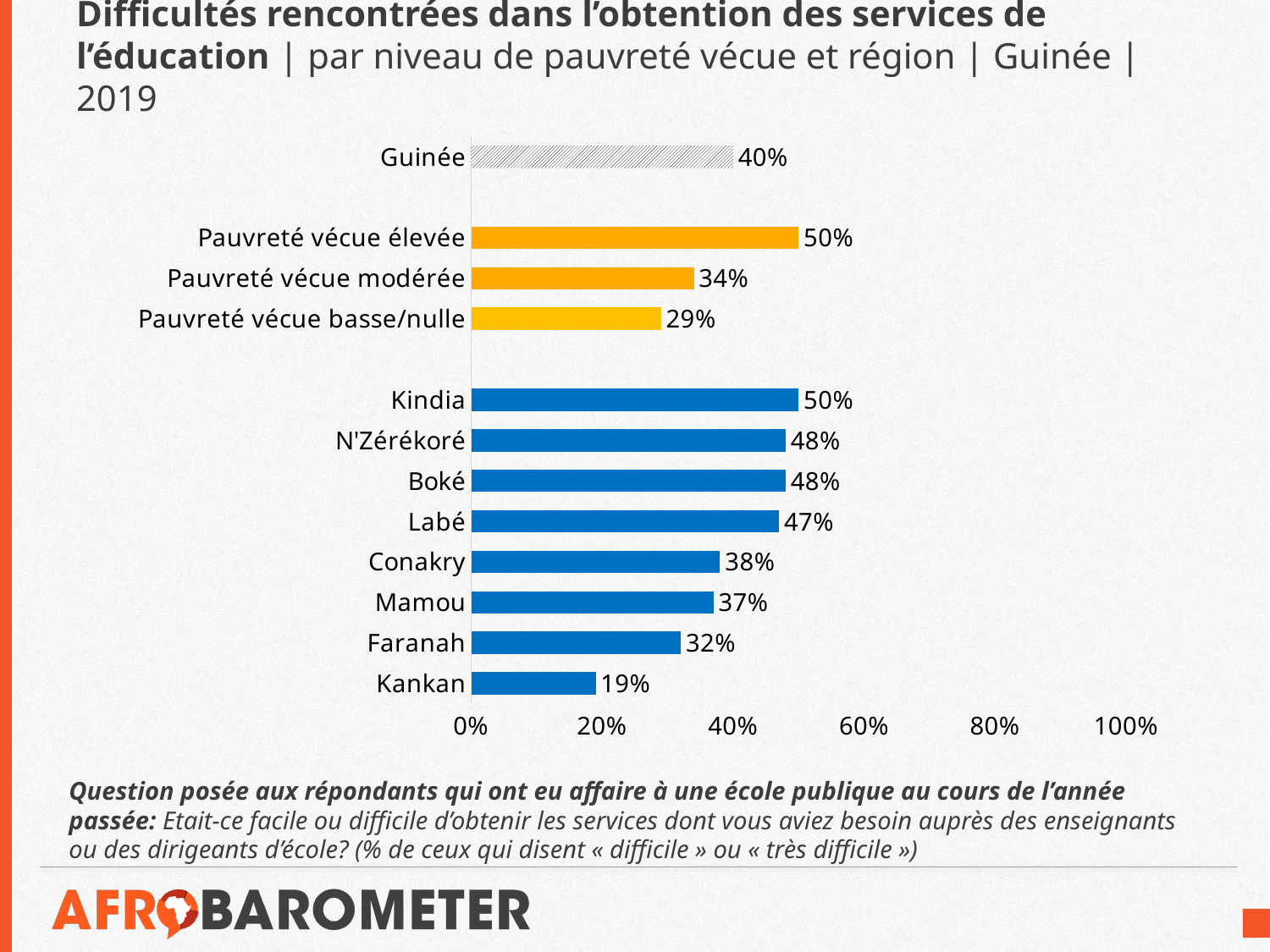
What is the value for Guinée? 40% Which is larger, the value for Labé or the value for Mamou? Labé Is the value for Faranah greater or less than 40%? less Which region has the highest value? Kindia What kind of chart is shown on the slide? Bar chart What is the difference between Kindia and Kankan? 31 percentage points How many regions are shown in the chart? 8 Which region has the lowest value? Kankan What is the difference between Pauvreté vécue élevée and Pauvreté vécue basse/nulle? 21 percentage points What is the value for Kankan? 19% What is the value for Conakry? 38% What is the value for Pauvreté vécue modérée? 34%